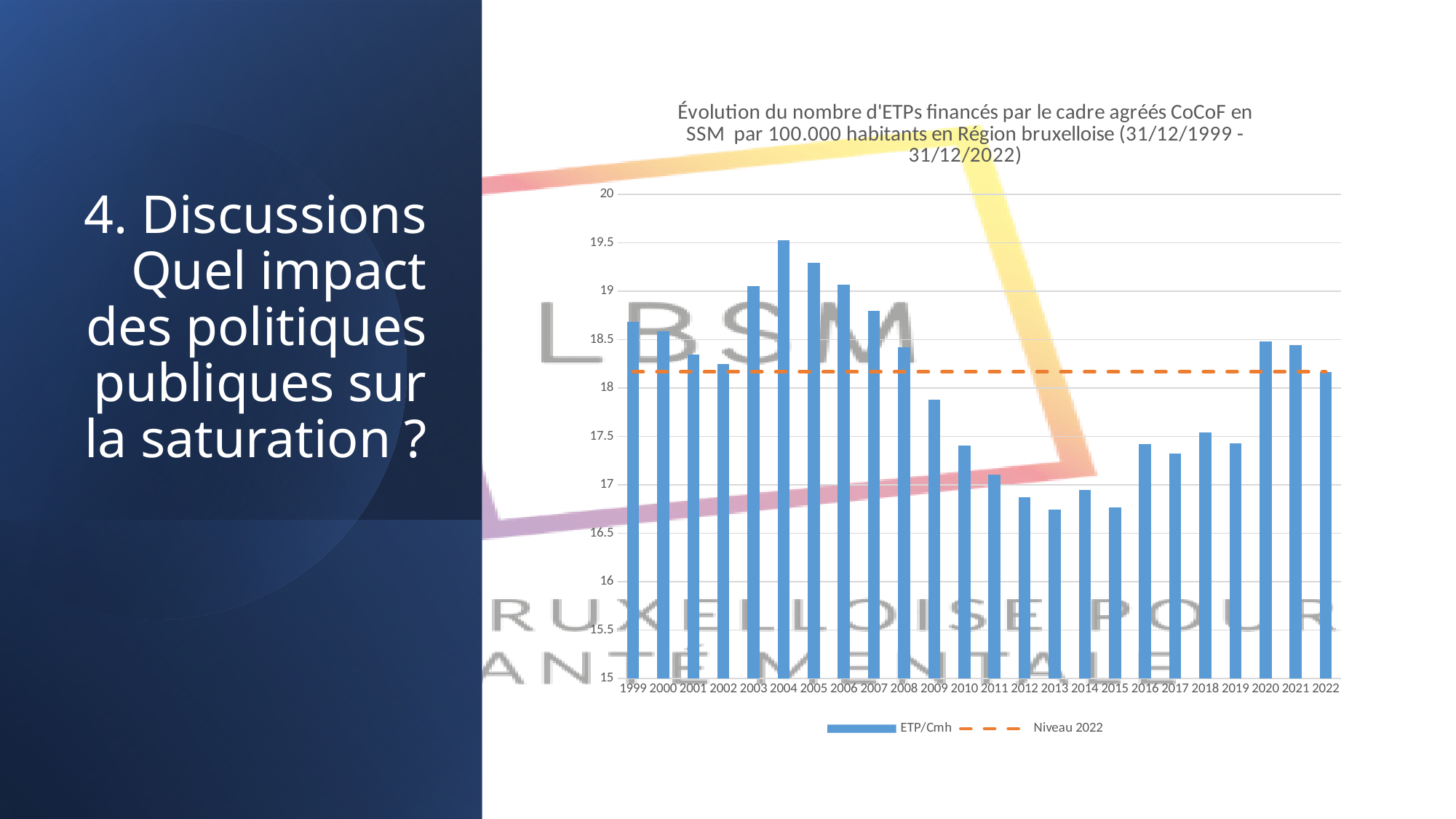
How many series does the legend list? 2 Which year has the highest ETP/Cmh value? 2004 Is the ETP/Cmh value for 2009 greater or less than 18? less What is the name of the series shown as blue bars? ETP/Cmh Which year has the larger ETP/Cmh value, 2003 or 2010? 2003 What kind of chart is shown on the slide? bar and line chart Is the ETP/Cmh value for 2013 greater or less than 17? less Do the ETP/Cmh values rise or fall from 2009 to 2013? fall Is the ETP/Cmh value for 2020 greater or less than 18? greater What is the name of the series shown as a dashed orange line? Niveau 2022 How many years are plotted on the x axis? 24